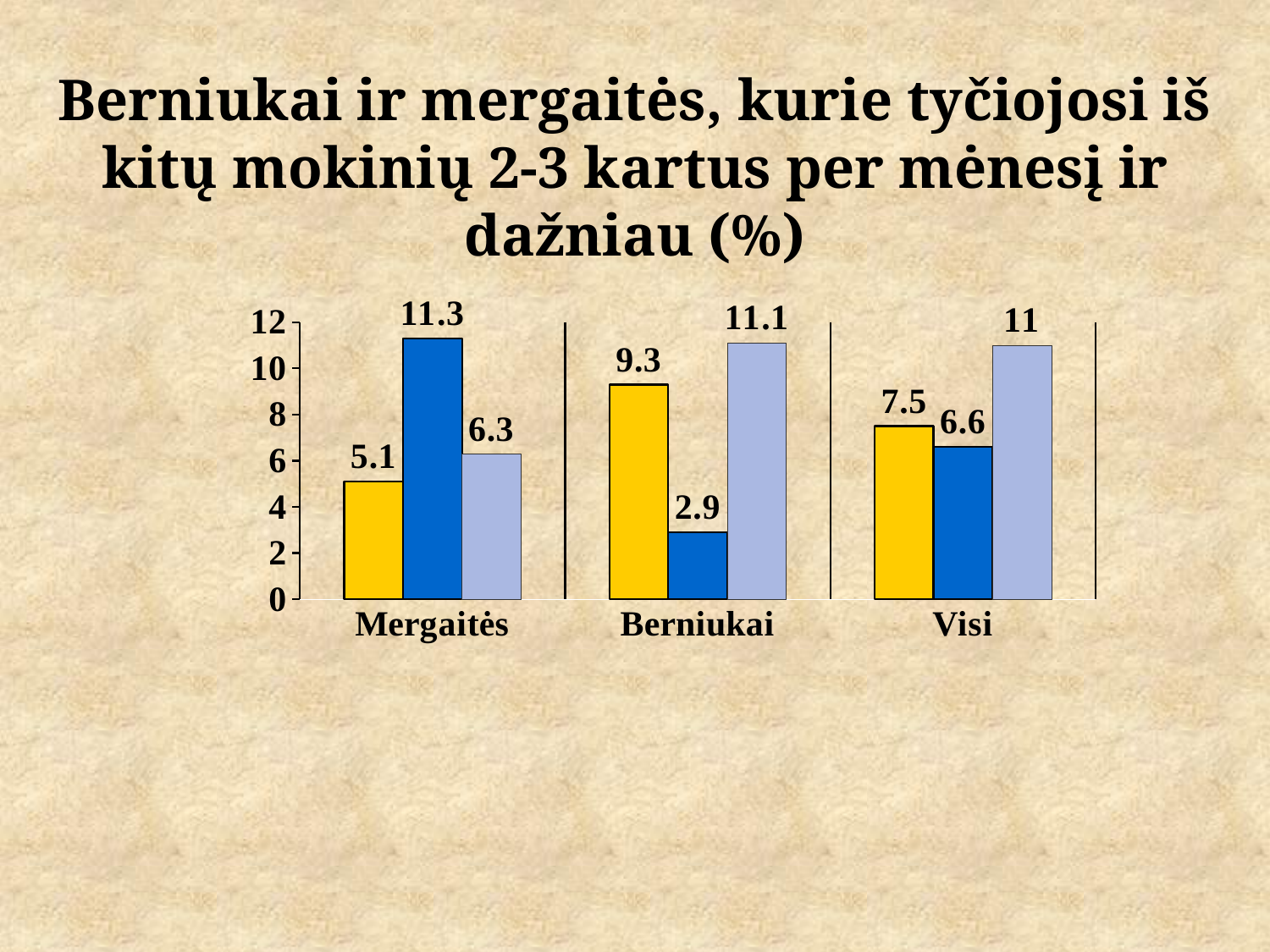
How many categories are shown on the x axis? 3 What is the value of the light blue bar for Visi? 11 What kind of chart is shown on the slide? bar chart Is the value of the dark blue bar for Mergaitės greater or less than 10? greater Which bar is the lowest in the Berniukai group? the dark blue bar (2.9) Which bar is the highest in the Mergaitės group? the dark blue bar (11.3) What is the value of the yellow bar for Visi? 7.5 Which is larger for Visi: the yellow bar or the dark blue bar? the yellow bar (7.5) What is the maximum value shown on the y axis? 12 What is the difference between the light blue bar and the yellow bar for Berniukai? 1.8 What is the value of the dark blue bar for Berniukai? 2.9 What is the value of the yellow bar for Mergaitės? 5.1